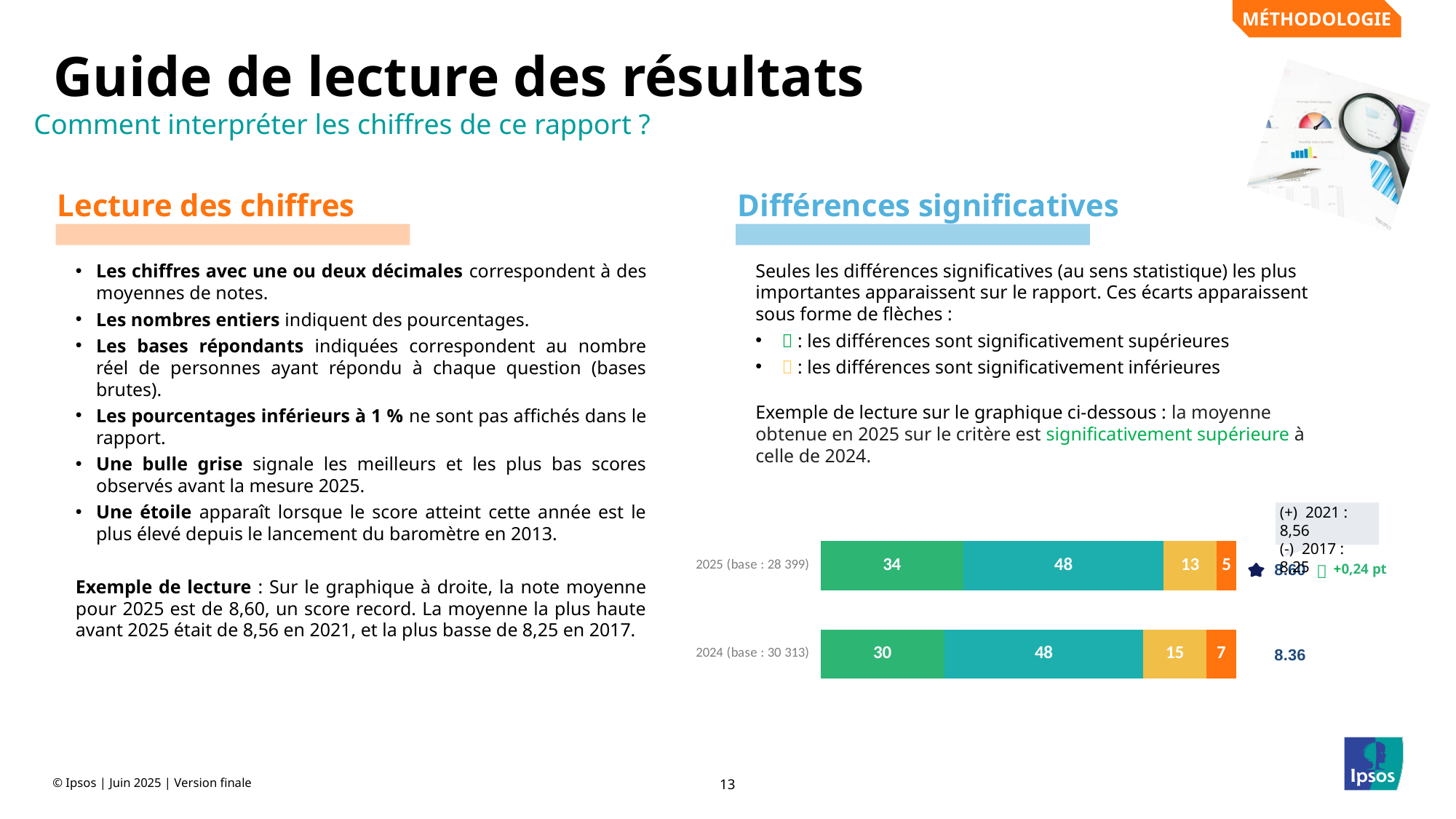
In the chart at the bottom right, what is the value of the yellow (third) segment of the 2024 bar? 15 In the chart at the bottom right, by how much does the green segment of the 2025 bar exceed the green segment of the 2024 bar? 4 What kind of chart is shown at the bottom right of the slide? stacked bar chart In the chart at the bottom right, what is the value of the orange (last) segment of the 2025 bar? 5 In the chart at the bottom right, what is the value of the green (first) segment of the 2025 bar? 34 In the chart at the bottom right, what average score is displayed next to the 2024 bar? 8.36 In the chart at the bottom right, is the orange (last) segment larger for 2024 or for 2025? 2024 In the chart at the bottom right, what is the total of the segments in the 2025 bar? 100 In the chart at the bottom right, what respondent base is indicated for the 2025 bar? 28 399 In the chart at the bottom right, what is the value of the teal (second) segment of the 2025 bar? 48 How many bars (years) does the chart at the bottom right show? 2 In the chart at the bottom right, what is the value of the green (first) segment of the 2024 bar? 30